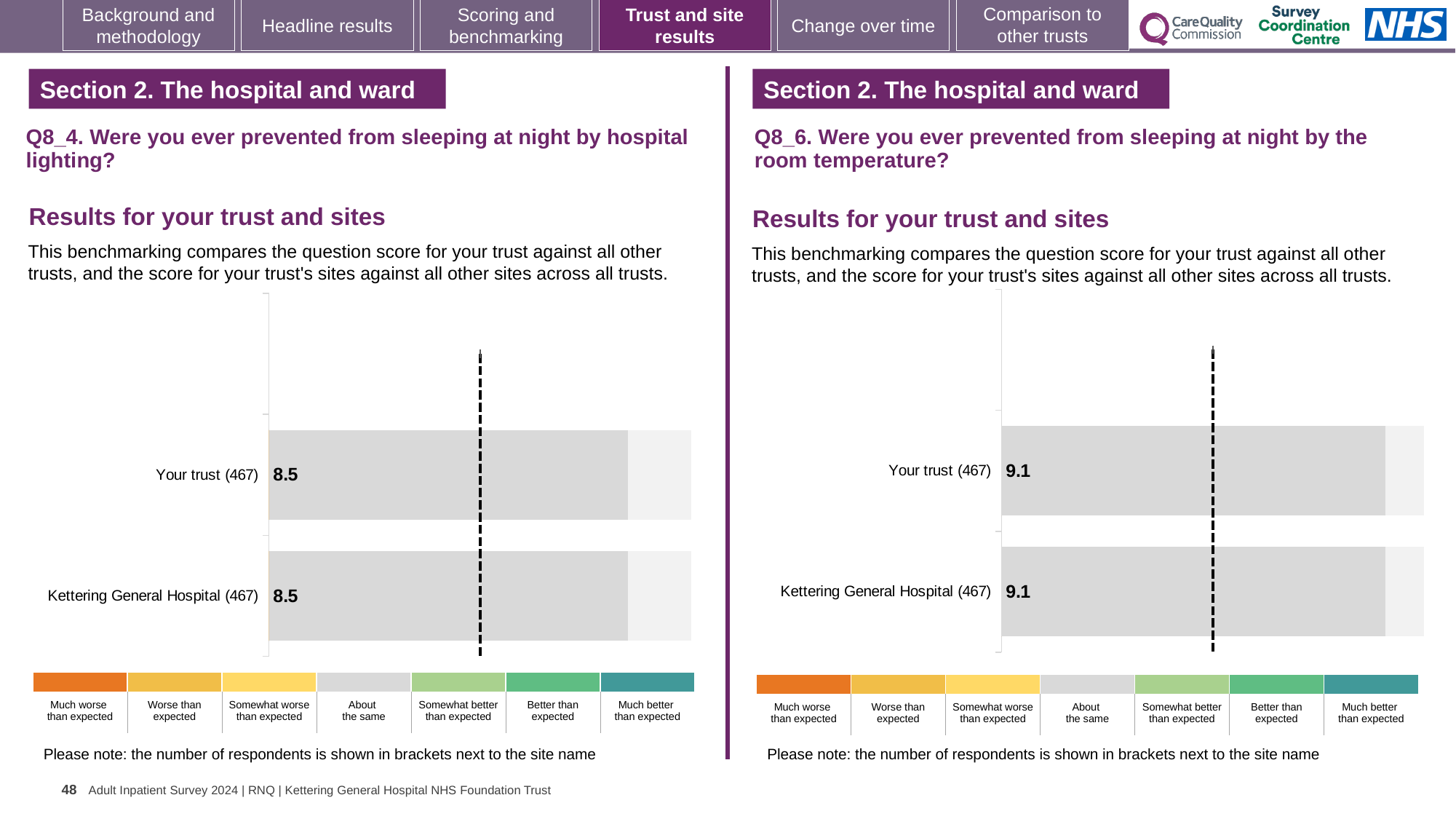
In the left chart (Q8_4, hospital lighting), how many respondents are shown in brackets next to Kettering General Hospital? 467 In the right chart (Q8_6, room temperature), what is the score for Kettering General Hospital? 9.1 In the left chart (Q8_4, hospital lighting), what is the score for Your trust? 8.5 How many benchmark categories are listed in the colour key below the right chart (Q8_6, room temperature)? 7 What kind of chart is used on the left side of the slide (Q8_4, hospital lighting)? Bar chart In the left chart (Q8_4, hospital lighting), what is the difference between the score for Your trust and the score for Kettering General Hospital? 0 In the left chart (Q8_4, hospital lighting), what is the score for Kettering General Hospital? 8.5 In the right chart (Q8_6, room temperature), what is the difference between the score for Your trust and the score for Kettering General Hospital? 0 How many bars are plotted in the right chart (Q8_6, room temperature)? 2 How many bars are plotted in the left chart (Q8_4, hospital lighting)? 2 In the right chart (Q8_6, room temperature), what is the score for Your trust? 9.1